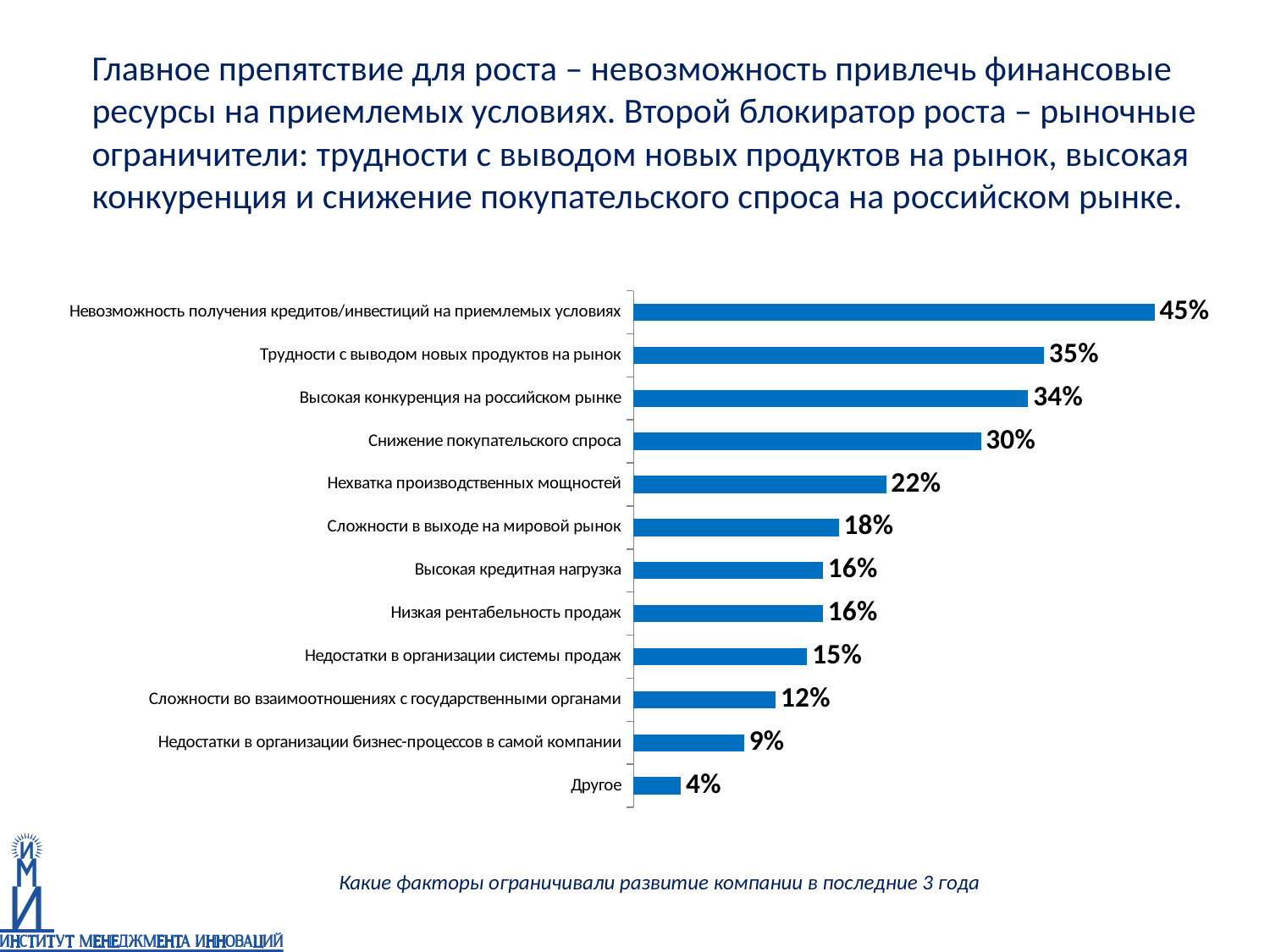
What is the difference between the values for "Высокая конкуренция на российском рынке" and "Другое"? 30% How many categories are shown in the chart? 12 What value is shown for "Сложности во взаимоотношениях с государственными органами"? 12% Which category has the lowest value? Другое Which is larger: the value for "Сложности в выходе на мировой рынок" or the value for "Недостатки в организации системы продаж"? Сложности в выходе на мировой рынок What value is shown for "Снижение покупательского спроса"? 30% Which category has the highest value? Невозможность получения кредитов/инвестиций на приемлемых условиях What question is written in italics below the chart? Какие факторы ограничивали развитие компании в последние 3 года What value is shown for "Невозможность получения кредитов/инвестиций на приемлемых условиях"? 45% What value is shown for "Недостатки в организации бизнес-процессов в самой компании"? 9% What kind of chart is shown on the slide? Bar chart What is the difference between the values for "Трудности с выводом новых продуктов на рынок" and "Нехватка производственных мощностей"? 13%